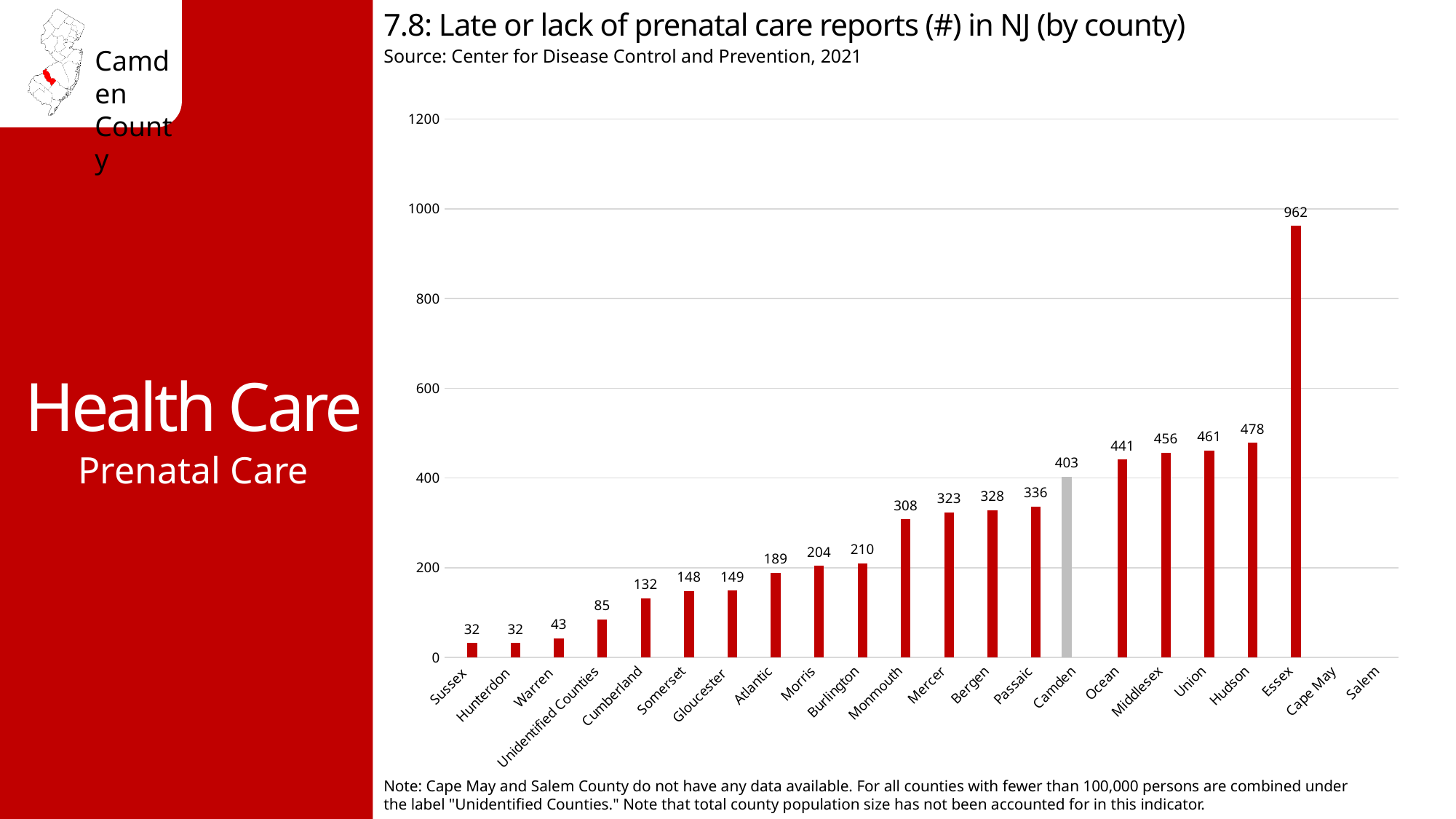
Which county's bar is coloured grey instead of red? Camden What is the difference between the values for Essex and Hudson? 484 What kind of chart is shown on the slide? Bar chart What is the value for Unidentified Counties? 85 Which is larger, the value for Cumberland or the value for Atlantic? Atlantic What is the value for Essex? 962 Which is larger, the value for Passaic or the value for Ocean? Ocean What is the value for Camden? 403 Do the values generally rise or fall from Sussex to Essex along the x axis? Rise What is the difference between the values for Camden and Ocean? 38 How many counties are listed along the x axis? 22 Which county has the highest number of late or lack of prenatal care reports? Essex